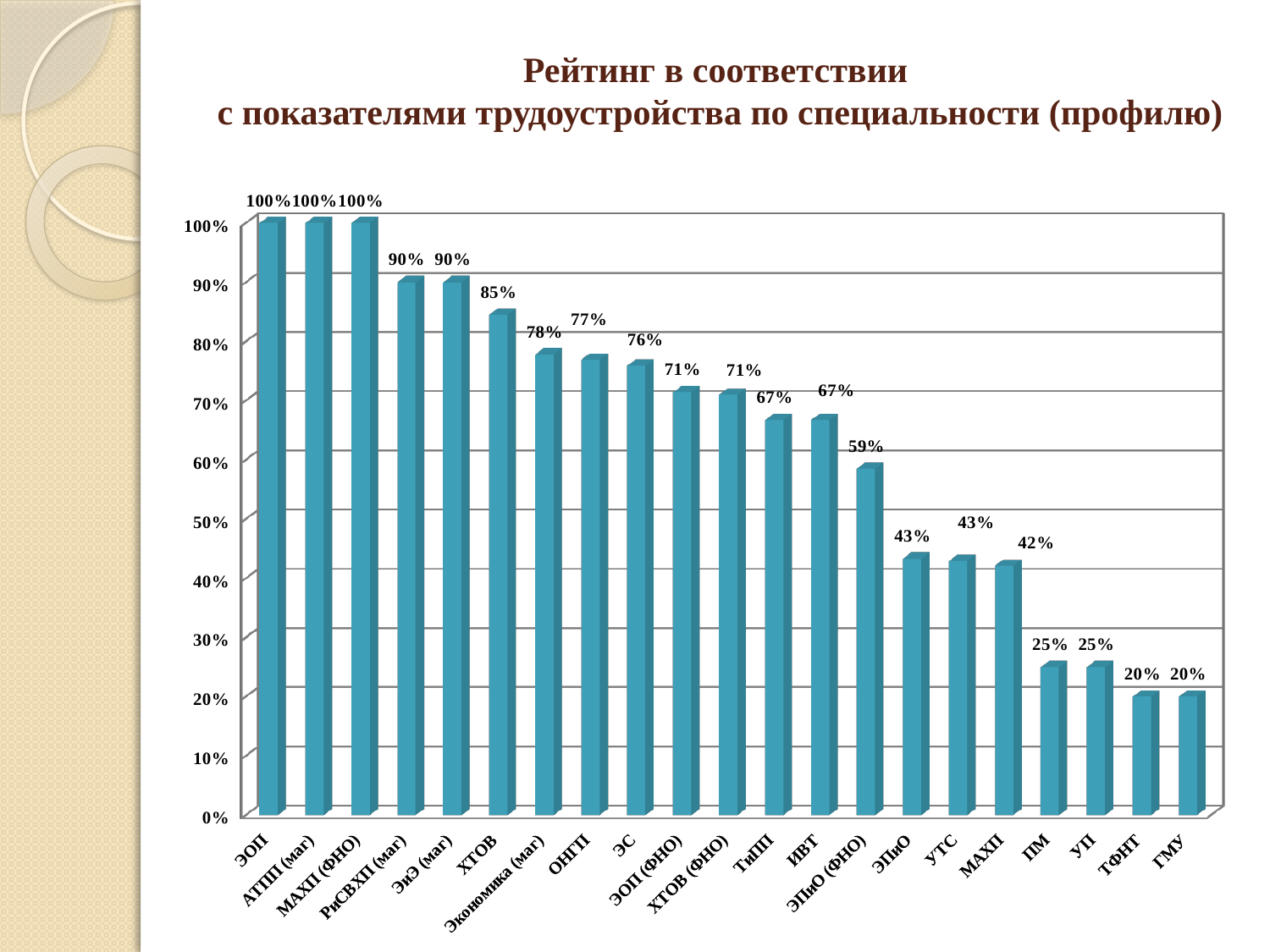
What is the difference between the values for ХТОВ and ЭС? 9% What is the value for ЭПиО (ФНО)? 59% How many categories are shown on the x axis? 21 Is the value for Экономика (маг) greater or less than 70%? greater Which categories share the lowest value on the chart? ТФНТ and ГМУ Do the values rise or fall from left to right along the x axis? fall What kind of chart is shown on the slide? bar chart What is the value for ОНГП? 77% What is the highest value shown on the chart? 100% What is the value for МАХП? 42% Which is larger, the value for ИВТ or the value for УТС? ИВТ What is the value for ХТОВ? 85%